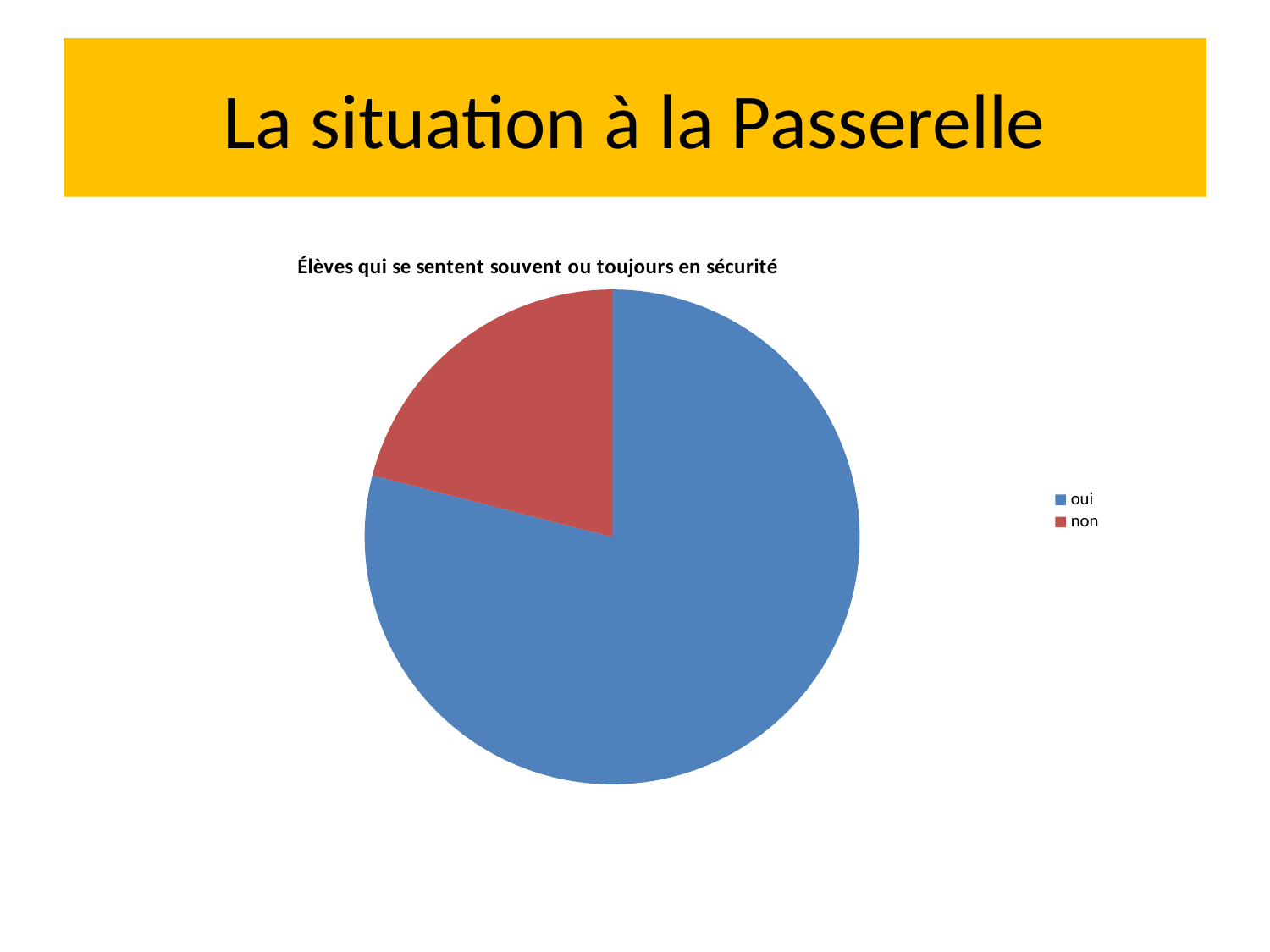
Which category has the smallest slice of the pie? non What is the title of the chart? Élèves qui se sentent souvent ou toujours en sécurité Which category has the largest slice of the pie? oui How many entries does the legend list? 2 What kind of chart is shown on the slide? pie chart What colour is the slice for non? red Which slice is larger, oui or non? oui How many slices does the pie chart have? 2